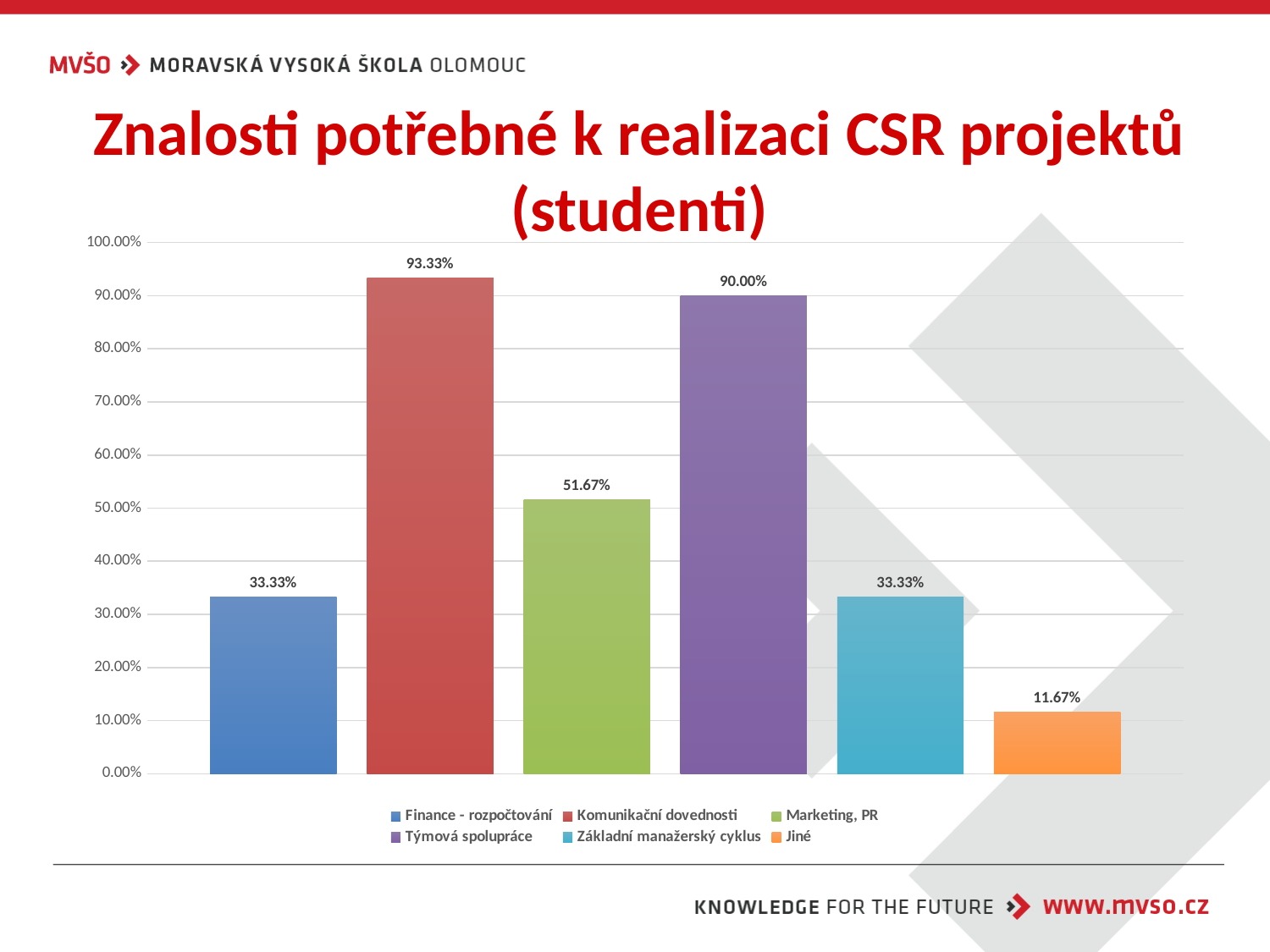
How many entries does the legend list? 6 What is the value for Komunikační dovednosti? 93.33% What is the value for Marketing, PR? 51.67% Which category has the highest value? Komunikační dovednosti Which is larger, the value for Marketing, PR or the value for Finance - rozpočtování? Marketing, PR What is the difference between the values for Komunikační dovednosti and Týmová spolupráce? 3.33% What is the difference between the values for Marketing, PR and Jiné? 40.00% How many bars are shown in the chart? 6 What is the value for Jiné? 11.67% Which category has the lowest value? Jiné What is the value for Týmová spolupráce? 90.00% What kind of chart is shown on the slide? Bar chart